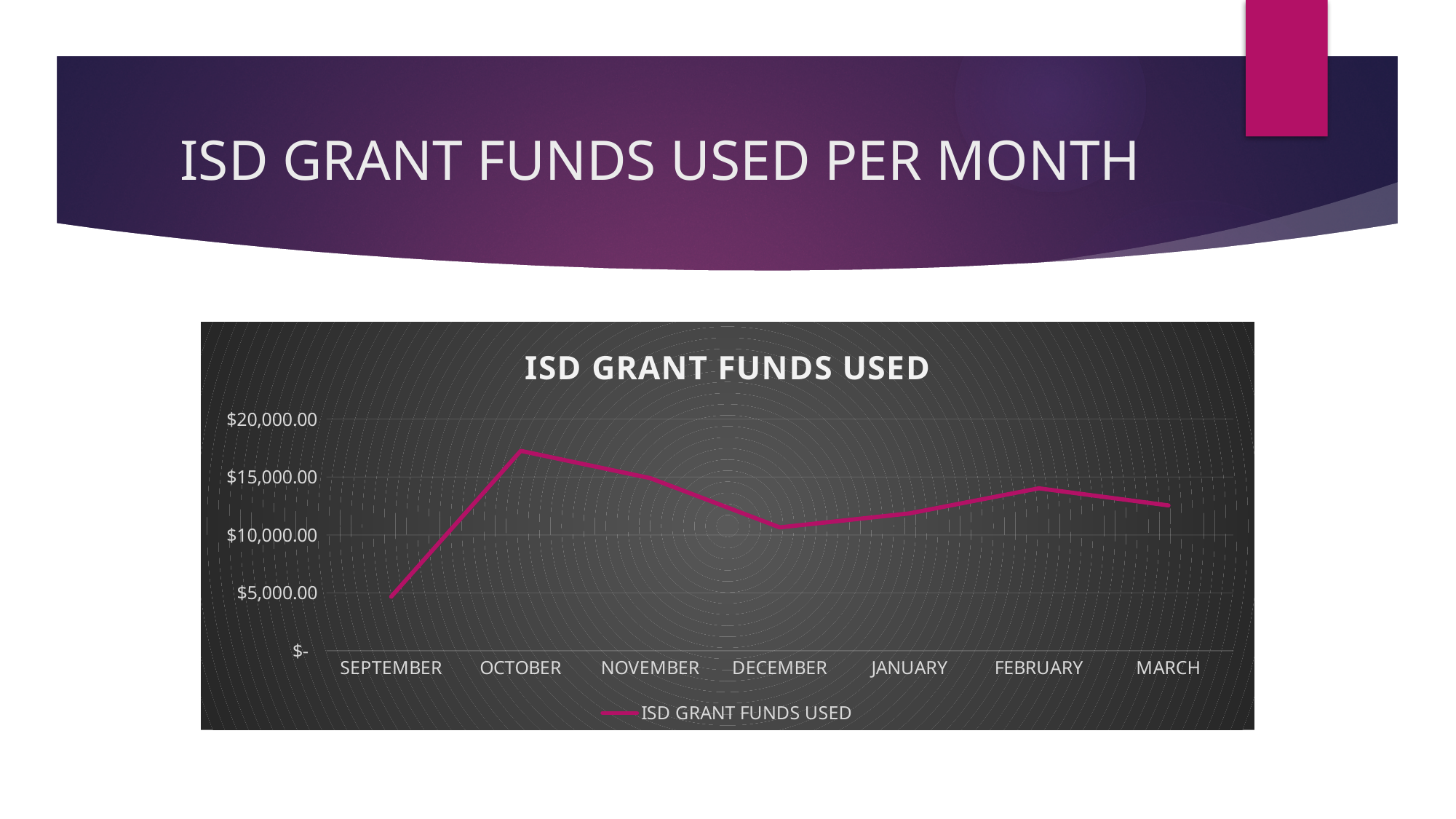
Is the value for February greater or less than $15,000.00? less How many months are plotted on the x axis of the chart? 7 What is the title of the chart? ISD GRANT FUNDS USED Which month has the highest ISD grant funds used? October Is the value for October greater or less than $15,000.00? greater What kind of chart is shown on the slide? line chart Do the ISD grant funds used rise or fall from September to October? rise How many series does the chart's legend list? 1 Which month has the larger value, October or December? October Which month has the lowest ISD grant funds used? September Is the value for December greater or less than $10,000.00? greater